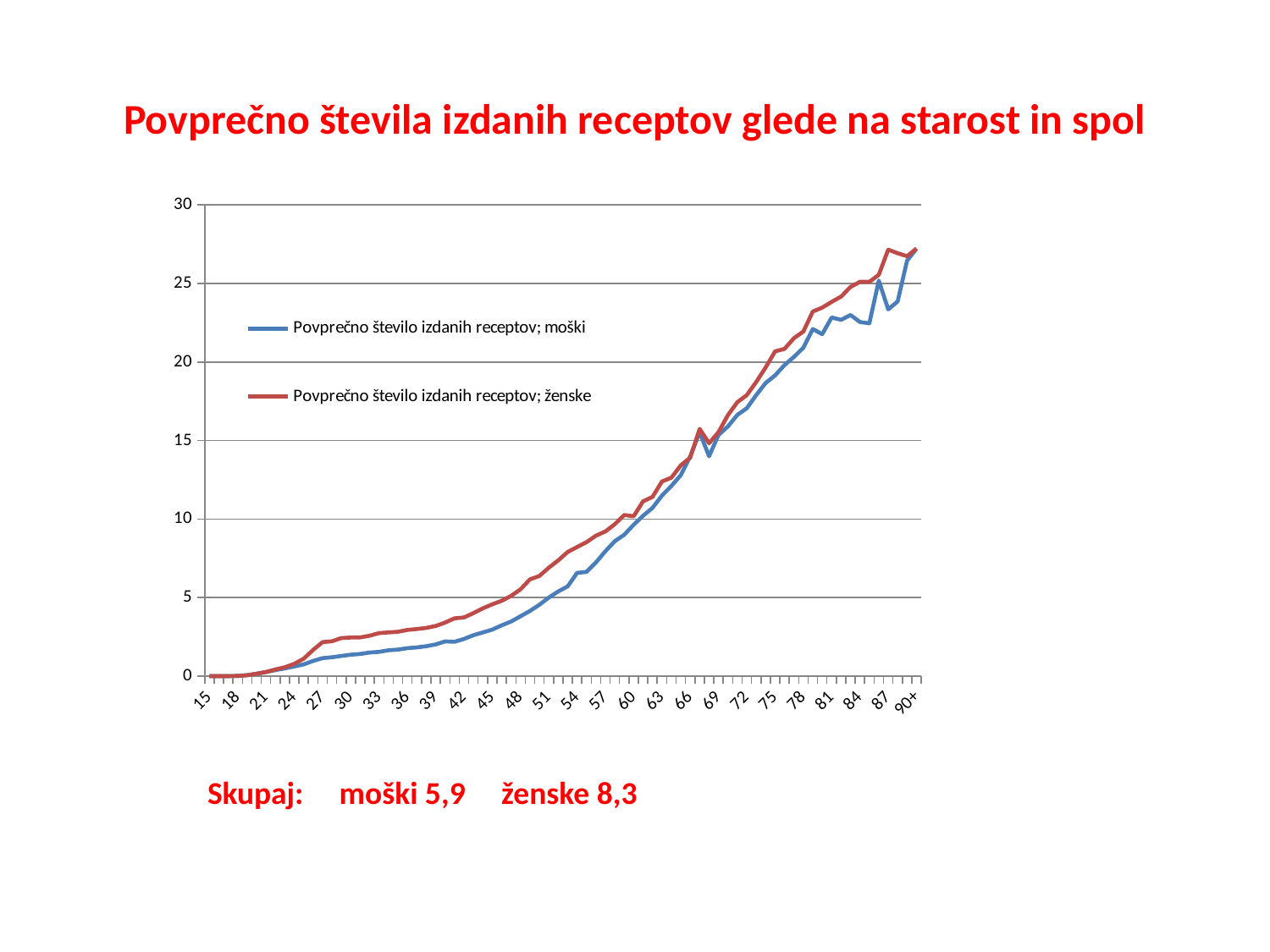
Which series is drawn in red? Povprečno število izdanih receptov; ženske Is the value for ženske at age 39 greater or less than 5? less Is the value for ženske at age 87 greater or less than 25? greater Is the value for moški at age 45 greater or less than 5? less How many series does the legend list? 2 At age 45, which series has the higher value, moški or ženske? ženske What kind of chart is shown on the slide? line chart At age 81, which series has the higher value, moški or ženske? ženske Do the values for both series rise or fall as age increases along the x axis? rise What is the title of the slide's chart? Povprečno števila izdanih receptov glede na starost in spol